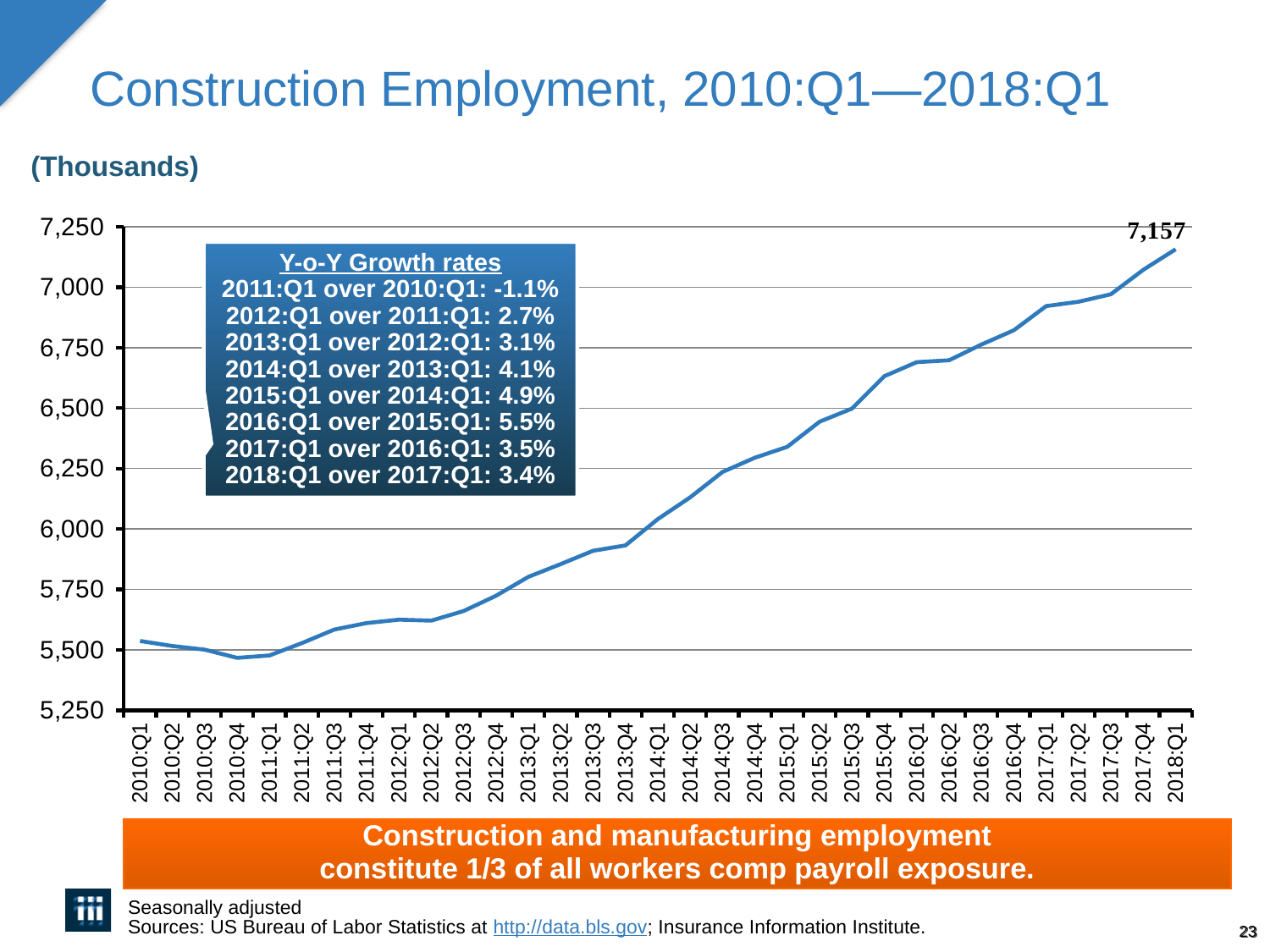
Is the value for 2010:Q1 greater or less than 5,750? less In what units are the values on the chart expressed? Thousands What kind of chart is shown on the slide? line chart Which quarter has the highest construction employment on the chart? 2018:Q1 Is the value for 2016:Q1 greater or less than 6,500? greater Which is larger, the value for 2018:Q1 or the value for 2010:Q1? 2018:Q1 Is the value for 2015:Q1 greater or less than 6,250? greater How many quarterly data points are plotted on the chart? 33 Overall, do the values rise or fall from 2010:Q1 to 2018:Q1? rise According to the text box on the chart, what was the Y-o-Y growth rate of 2016:Q1 over 2015:Q1? 5.5% What is the construction employment value labeled at 2018:Q1? 7,157